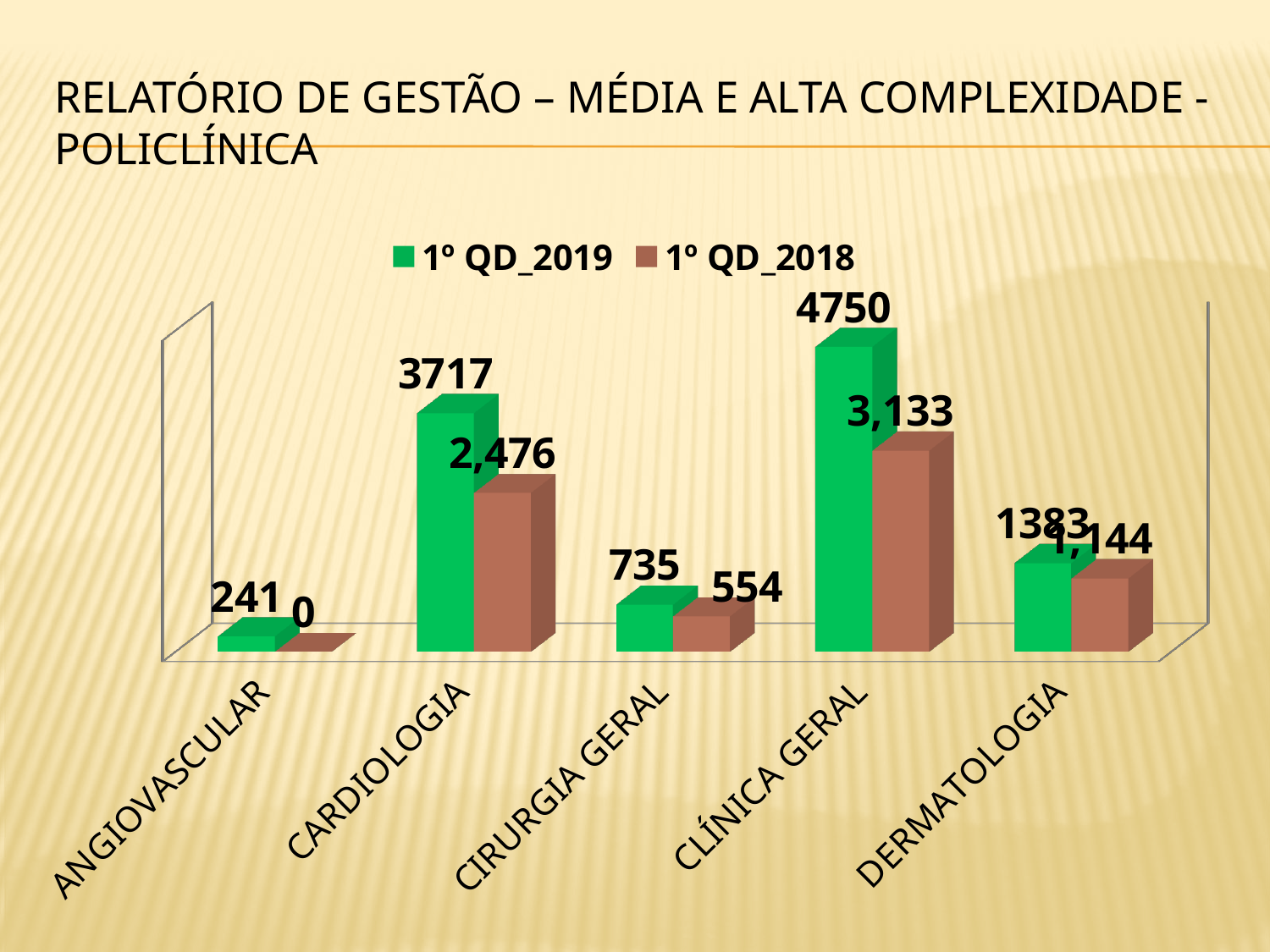
What is the difference between the 1º QD_2019 and 1º QD_2018 values for CARDIOLOGIA? 1241 Which category has the lowest value in the 1º QD_2018 series? ANGIOVASCULAR What is the value for CIRURGIA GERAL in the 1º QD_2019 series? 735 Which category has the highest value in the 1º QD_2019 series? CLÍNICA GERAL What is the value for ANGIOVASCULAR in the 1º QD_2018 series? 0 For CIRURGIA GERAL, which series has the larger value, 1º QD_2019 or 1º QD_2018? 1º QD_2019 What is the difference between the 1º QD_2019 and 1º QD_2018 values for CLÍNICA GERAL? 1617 How many categories are shown on the x axis of the chart? 5 What is the value for CLÍNICA GERAL in the 1º QD_2019 series? 4750 How many series does the legend list? 2 What is the value for CARDIOLOGIA in the 1º QD_2018 series? 2,476 What kind of chart is shown on the slide? Bar chart